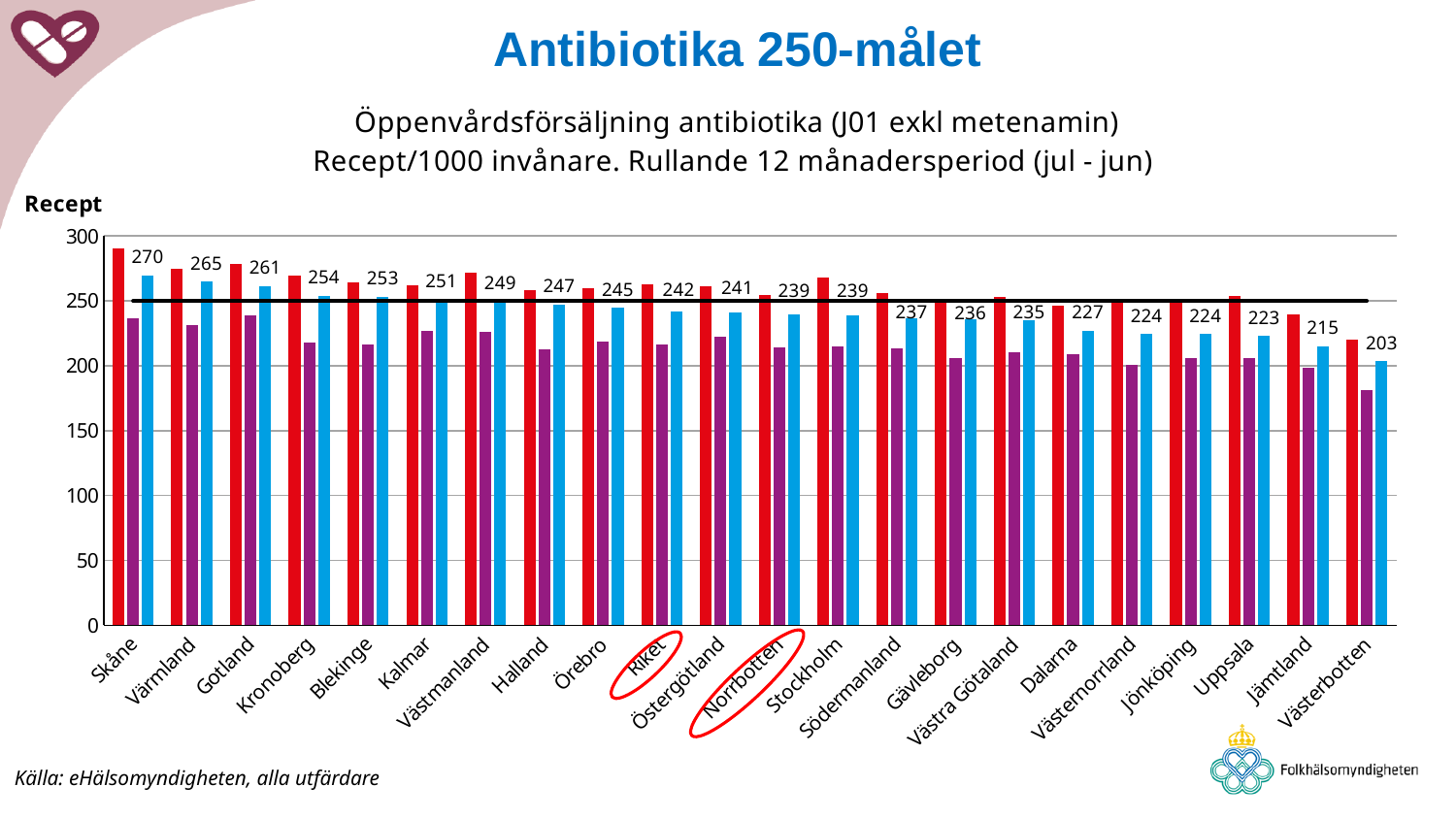
What is the labeled value for Riket? 242 Is the value of the purple bar for Västerbotten greater or less than 200? less Which has the larger labeled value, Gotland or Uppsala? Gotland Which region has the highest labeled value? Skåne What kind of chart is shown on the slide? Bar chart What is the labeled value for Skåne? 270 Do the labeled values rise or fall from left to right along the x axis? Fall Which region has the lowest labeled value? Västerbotten How many regions are shown on the x axis? 22 What is the labeled value for Västerbotten? 203 What is the difference between the labeled values for Skåne and Västerbotten? 67 Is the value of the red bar for Skåne greater or less than 250? greater